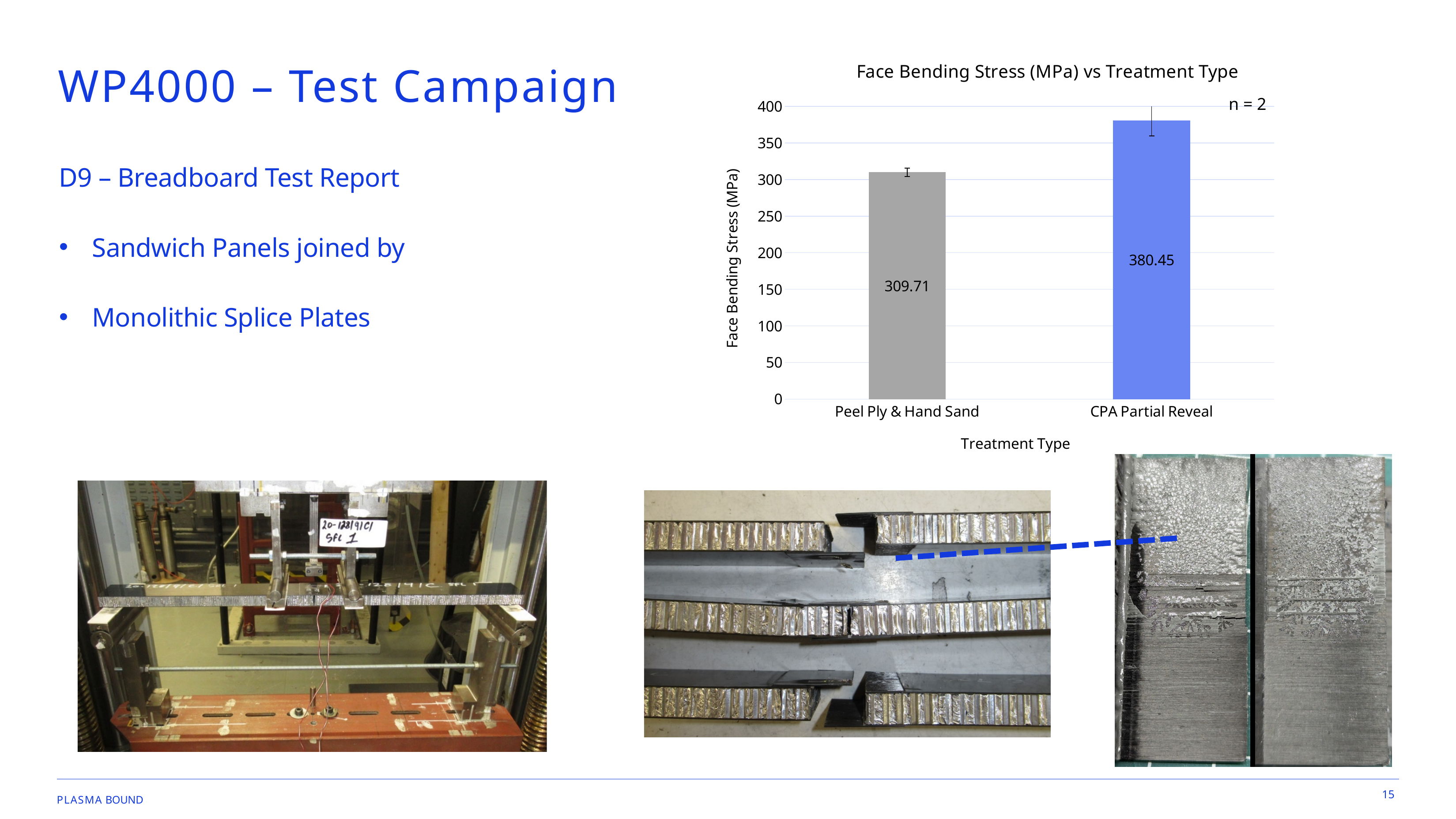
Which treatment type has the lowest face bending stress? Peel Ply & Hand Sand What kind of chart is shown on the slide? bar chart What is the difference in face bending stress between CPA Partial Reveal and Peel Ply & Hand Sand? 70.74 Which has a larger face bending stress, Peel Ply & Hand Sand or CPA Partial Reveal? CPA Partial Reveal What is the face bending stress for Peel Ply & Hand Sand? 309.71 What is the face bending stress for CPA Partial Reveal? 380.45 Is the value for Peel Ply & Hand Sand greater or less than 350? less How many treatment types are shown in the chart? 2 What is the label of the x axis of the chart? Treatment Type What is the title of the chart? Face Bending Stress (MPa) vs Treatment Type Which treatment type has the highest face bending stress? CPA Partial Reveal Is the value for CPA Partial Reveal greater or less than 350? greater